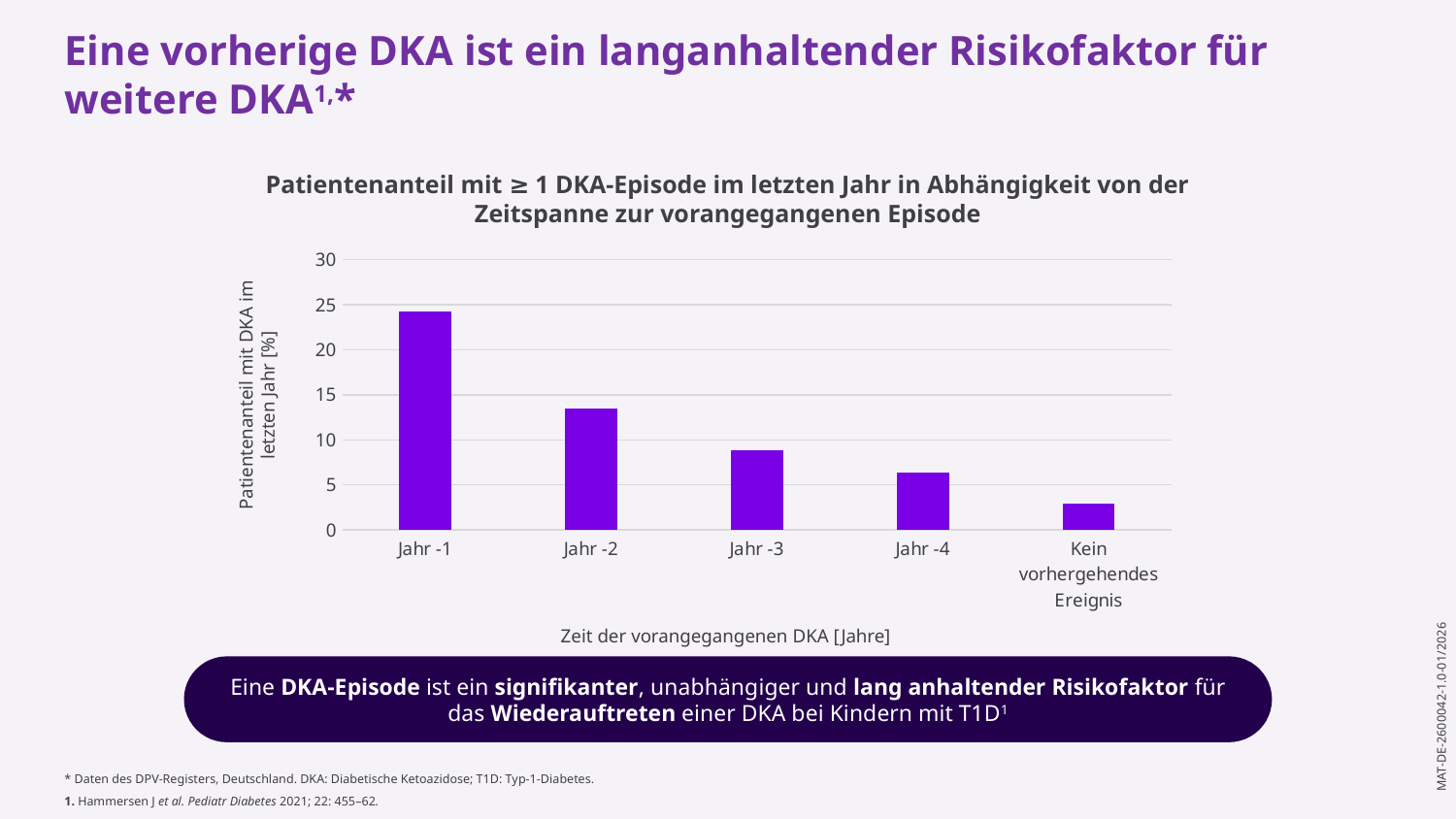
What kind of chart is shown on the slide? bar chart Which is larger, the value for Jahr -2 or the value for Jahr -3? Jahr -2 Is the value for Jahr -2 greater or less than 10? greater Which category has the lowest value in the chart? Kein vorhergehendes Ereignis Is the value for Kein vorhergehendes Ereignis greater or less than 5? less Which category has the highest value in the chart? Jahr -1 How many categories are shown on the x axis of the chart? 5 What is the label of the y axis of the chart? Patientenanteil mit DKA im letzten Jahr [%] Is the value for Jahr -4 greater or less than 5? greater Do the values rise or fall from Jahr -1 to Kein vorhergehendes Ereignis along the x axis? fall